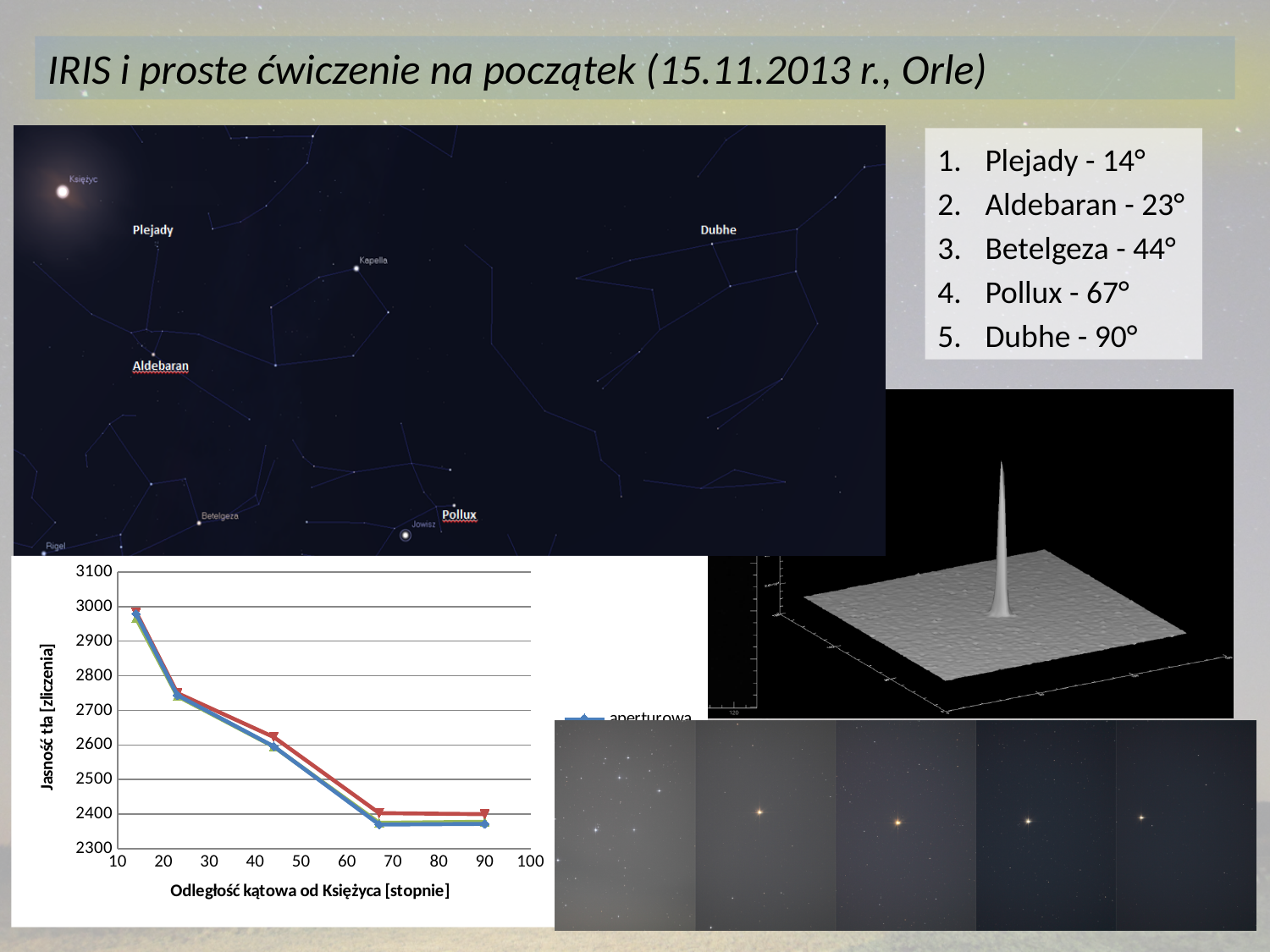
In the chart, is the value of the blue series at about 67 degrees greater or less than 2400? less In the chart, is the background brightness at about 23 degrees greater or less than 2700? greater At which angular distance is the background brightness highest in the chart? 14 degrees (the leftmost point) In the line chart, do the values rise or fall as the angular distance from the Moon increases? fall In the chart, is the background brightness at about 14 degrees greater or less than 2900? greater In the chart, which is larger: the background brightness at about 14 degrees or at about 90 degrees? at about 14 degrees What is the title of the vertical axis of the chart? Jasność tła [zliczenia] How many data points does each line in the chart have? 5 What is the title of the horizontal axis of the chart? Odległość kątowa od Księżyca [stopnie] What kind of chart is shown at the bottom left of the slide? line chart